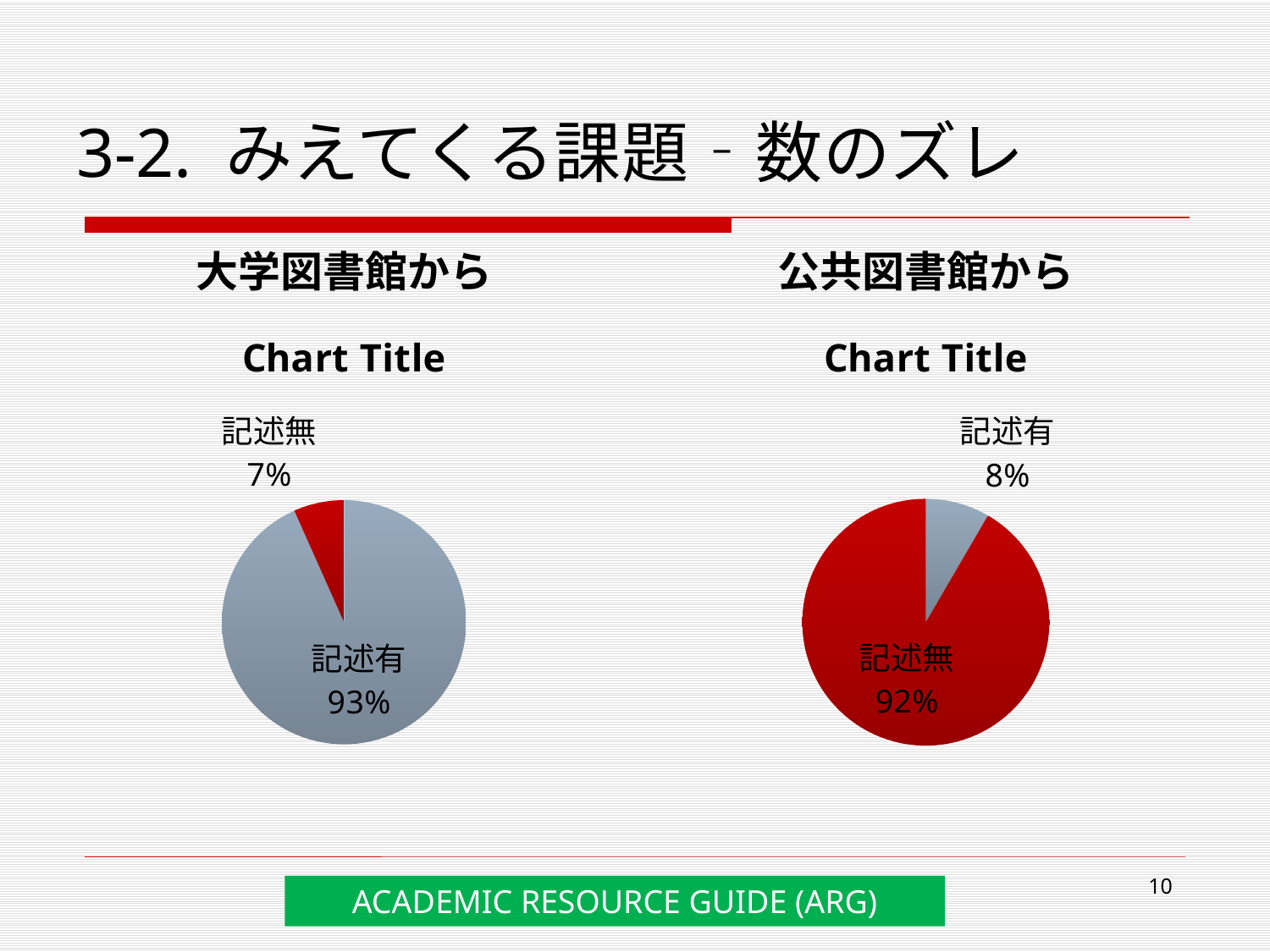
What title is printed above the right pie chart (公共図書館から)? Chart Title What kind of chart is the left chart (under 大学図書館から)? pie chart Which is larger: 記述有 in the left pie chart (大学図書館から) or 記述有 in the right pie chart (公共図書館から)? 記述有 in the left pie chart In the left pie chart (大学図書館から), which slice is the largest? 記述有 In the right pie chart (公共図書館から), what share does 記述有 have? 8% In the left pie chart (大学図書館から), what share does 記述無 have? 7% In the right pie chart (公共図書館から), what share does 記述無 have? 92% In the left pie chart (大学図書館から), what share does 記述有 have? 93% In the right pie chart (公共図書館から), which slice is the smallest? 記述有 In the left pie chart (大学図書館から), what is the difference between the 記述有 and 記述無 shares? 86% In the right pie chart (公共図書館から), what is the difference between the 記述無 and 記述有 shares? 84% How many slices does the left pie chart (大学図書館から) have? 2